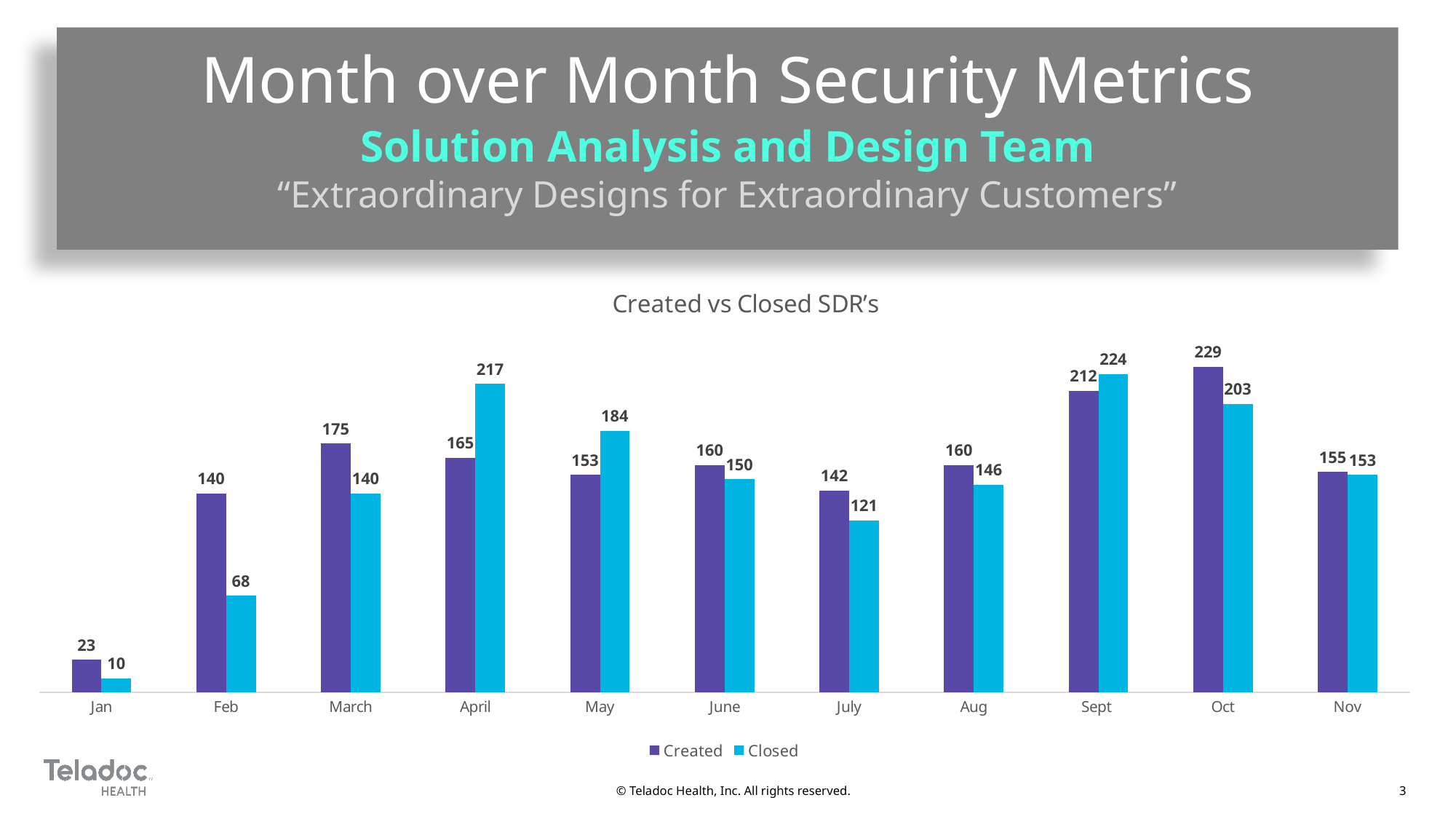
In May, which is larger, Created or Closed? Closed What is the title of the chart? Created vs Closed SDR's What is the Created value for April? 165 Which month has the highest Created value? Oct What kind of chart is shown? Bar chart Which month has the lowest Closed value? Jan What is the difference between Created and Closed in Sept? 12 How many series does the legend list? 2 Which series is shown in purple? Created What is the difference between the Created values for Oct and Nov? 74 What is the Closed value for Feb? 68 How many months are shown on the x axis? 11